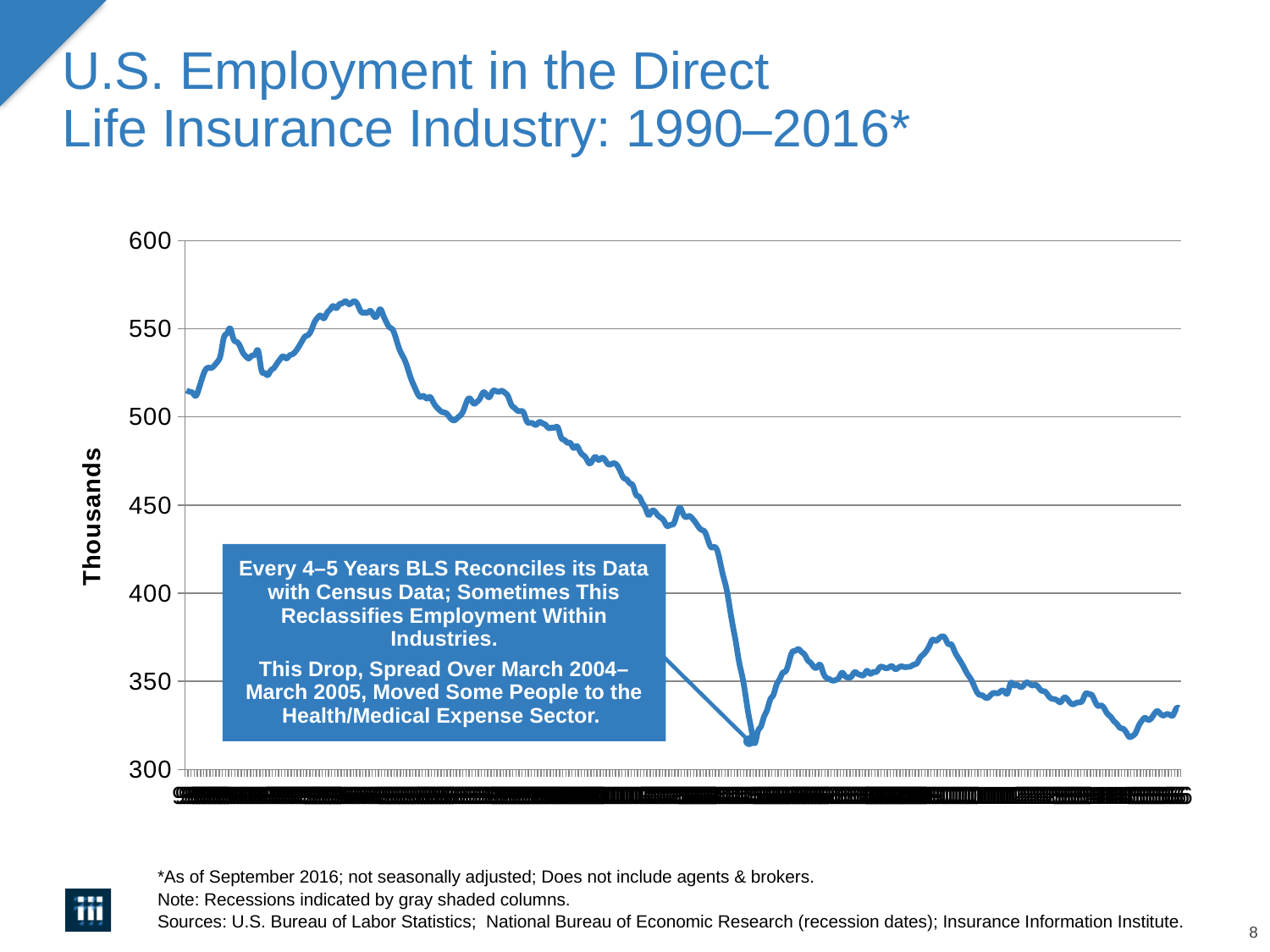
Is the value at the end of the series (September 2016) greater or less than 350? less Is the value at the start of the series (1990) greater or less than 500? greater What kind of chart is shown on the slide? line chart Is the value at the start of the series (1990) greater or less than 550? less Overall, do the values rise or fall from the left of the chart (1990) to the right (2016)? fall Is the value at the end of the series (2016) larger or smaller than the value at the start (1990)? smaller What is the title of the chart? U.S. Employment in the Direct Life Insurance Industry: 1990–2016* What unit does the vertical axis label give for the values? Thousands